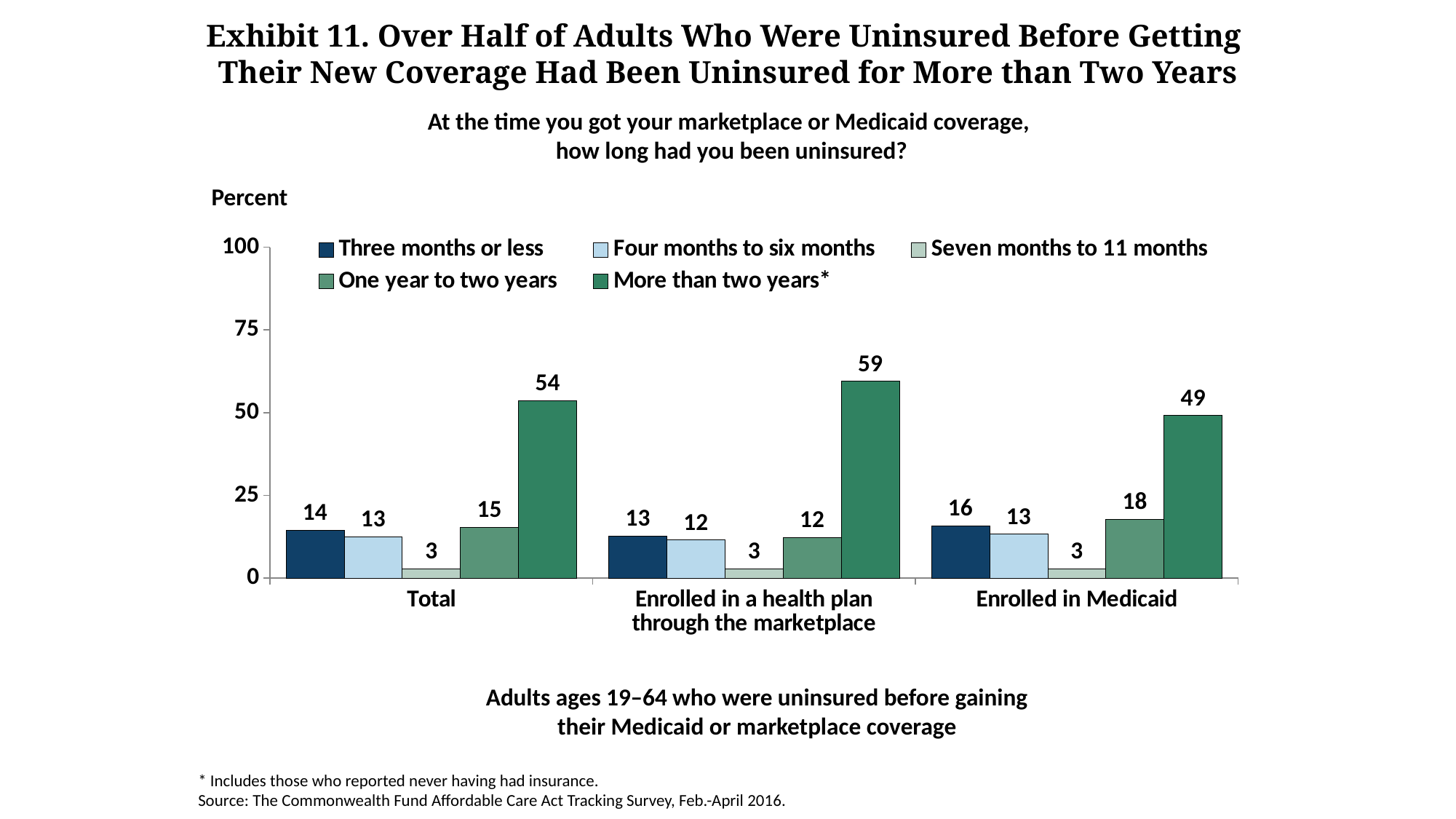
What is the value for "More than two years" in the Total group? 54 Which group has the highest value for "More than two years"? Enrolled in a health plan through the marketplace What is the value for "One year to two years" among those enrolled in a health plan through the marketplace? 12 What is the value for "Three months or less" among those enrolled in Medicaid? 16 Which is larger: "One year to two years" for Enrolled in Medicaid or for Total? Enrolled in Medicaid Which series has the lowest value in the Total group? Seven months to 11 months What kind of chart is shown? Bar chart Which legend entry is marked with an asterisk? More than two years What is the difference between the "More than two years" values for the marketplace group and the Medicaid group? 10 Is the value for "More than two years" in the Total group greater or less than 50? greater How many groups are shown on the x axis? 3 How many series does the legend list? 5